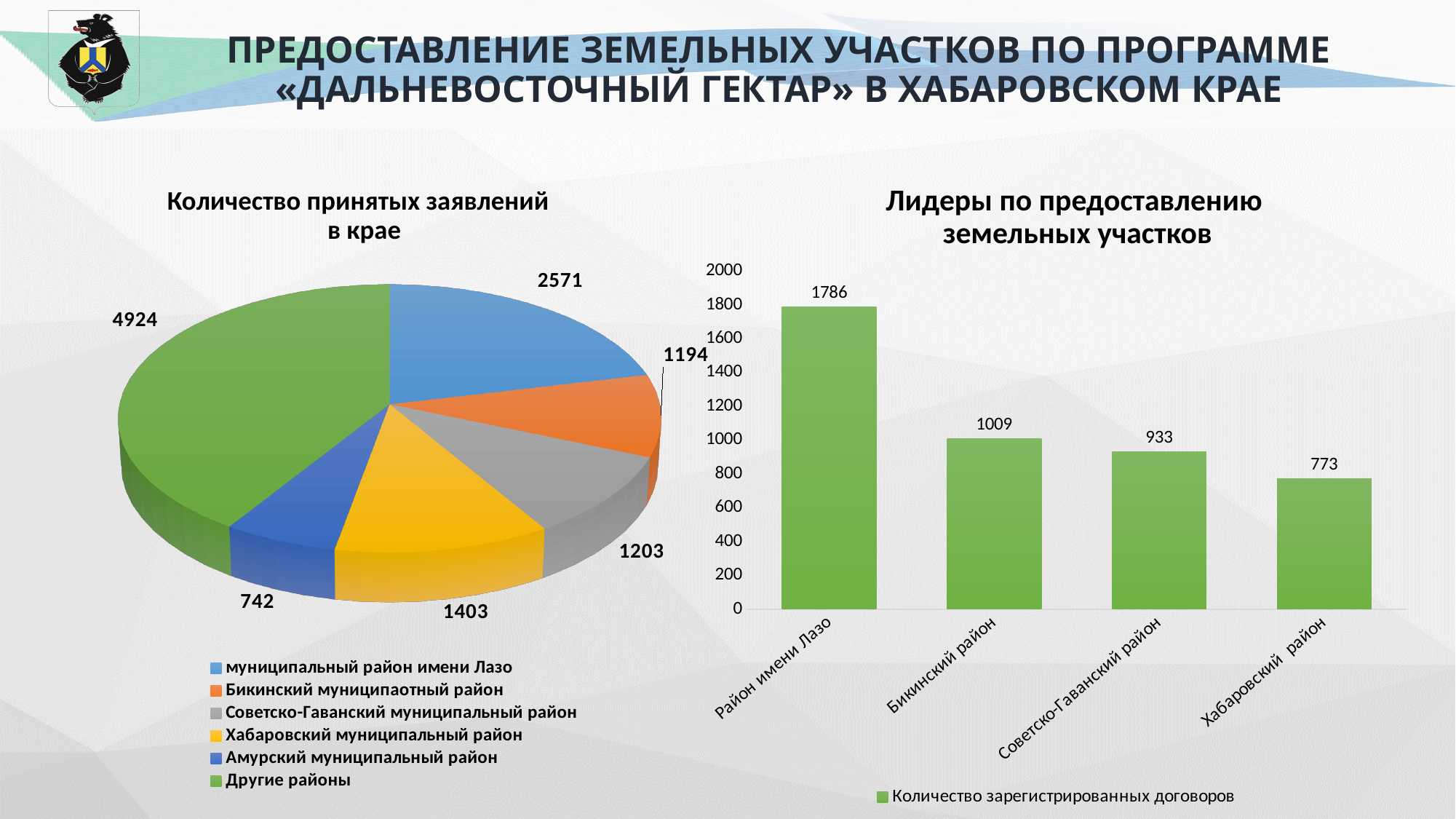
In the chart 'Лидеры по предоставлению земельных участков', do the values rise or fall from left to right? fall In the pie chart 'Количество принятых заявлений в крае', what is the value for Амурский муниципальный район? 742 In the pie chart 'Количество принятых заявлений в крае', which category has the largest value? Другие районы In the pie chart 'Количество принятых заявлений в крае', what is the difference between Другие районы and муниципальный район имени Лазо? 2353 How many categories does the legend of the pie chart 'Количество принятых заявлений в крае' list? 6 In the chart 'Лидеры по предоставлению земельных участков', what is the value for Район имени Лазо? 1786 In the chart 'Лидеры по предоставлению земельных участков', what is the value for Хабаровский район? 773 In the chart 'Лидеры по предоставлению земельных участков', how many districts are shown? 4 What kind of chart is 'Лидеры по предоставлению земельных участков'? bar chart In the pie chart 'Количество принятых заявлений в крае', which is larger: муниципальный район имени Лазо or Хабаровский муниципальный район? муниципальный район имени Лазо In the chart 'Лидеры по предоставлению земельных участков', which district has the lowest value? Хабаровский район In the chart 'Лидеры по предоставлению земельных участков', what is the difference between Бикинский район and Советско-Гаванский район? 76